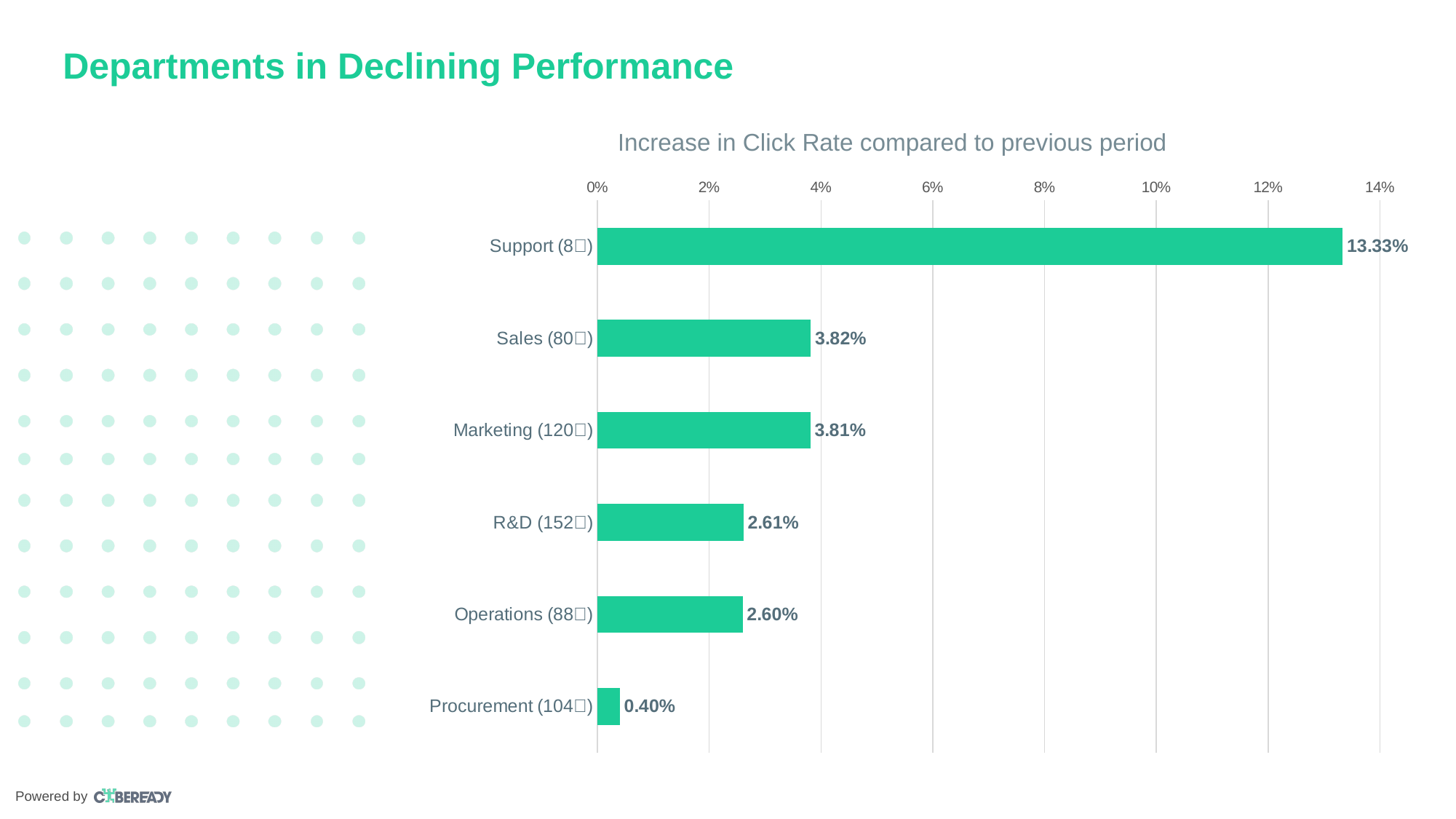
Which department has the highest increase in click rate? Support What is the difference between the increase in click rate for Support and for Sales? 9.51% What is the title of the chart? Increase in Click Rate compared to previous period What is the increase in click rate for the Support department? 13.33% What kind of chart is shown on the slide? Bar chart What is the increase in click rate for R&D? 2.61% Which has a larger increase in click rate, Marketing or R&D? Marketing What is the increase in click rate for Procurement? 0.40% Is the value for Support greater or less than 12%? greater How many departments are shown in the chart? 6 What is the increase in click rate for Operations? 2.60% Which department has the lowest increase in click rate? Procurement